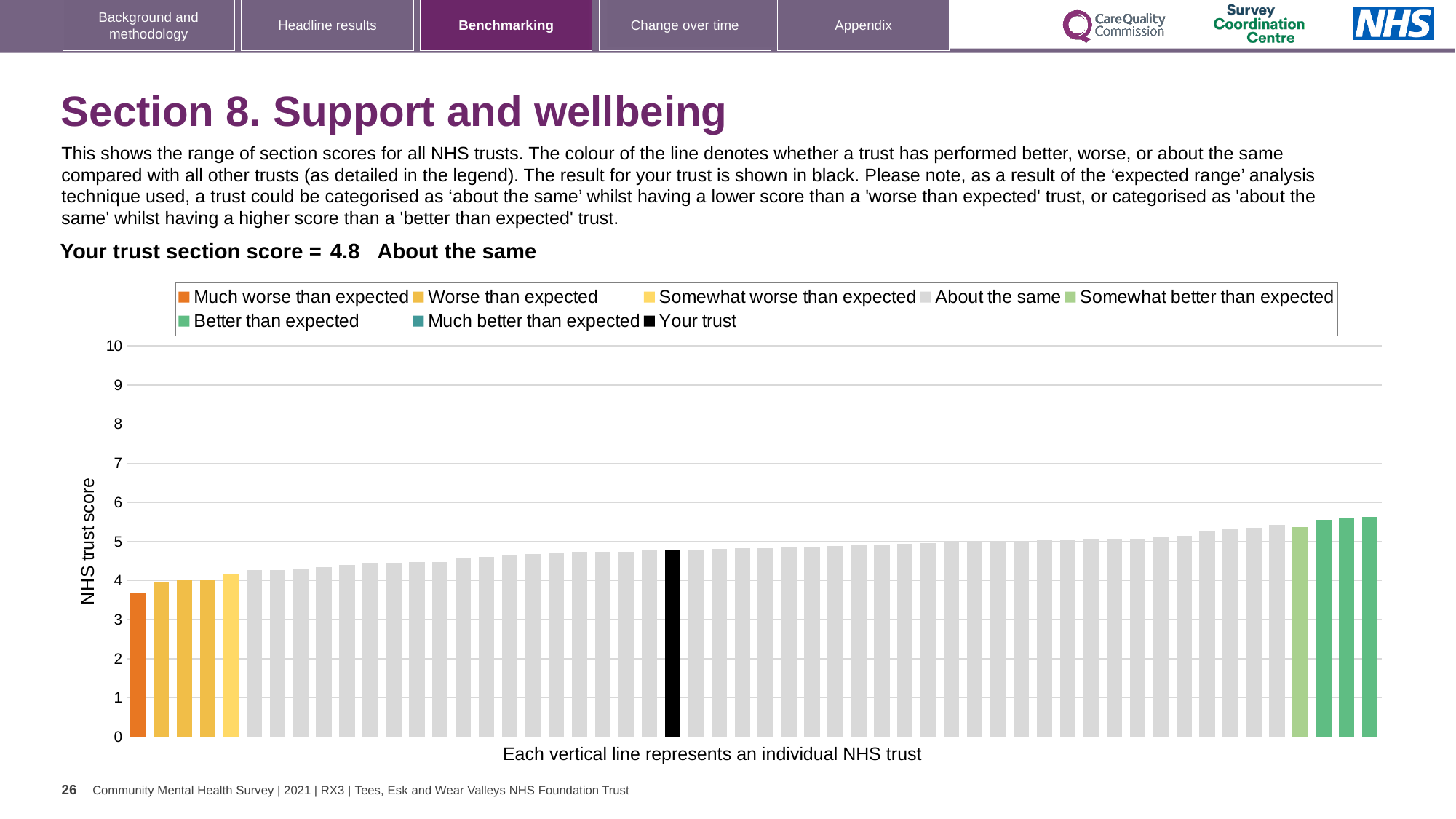
How many entries does the chart legend list? 8 What is the title of the vertical axis? NHS trust score Is the value of the tallest bar greater or less than 6? less Which legend category does the tallest bar belong to? Better than expected Is the value of the leftmost (orange) bar greater or less than 4? less What kind of chart is shown on the slide? bar chart Which benchmarking category is your trust placed in for this section? About the same What is the section score for your trust shown on the slide? 4.8 How many bars are coloured orange (Much worse than expected)? 1 Do the bar values rise or fall from left to right along the x axis? rise Is the value of the black bar (your trust) greater or less than 5? less